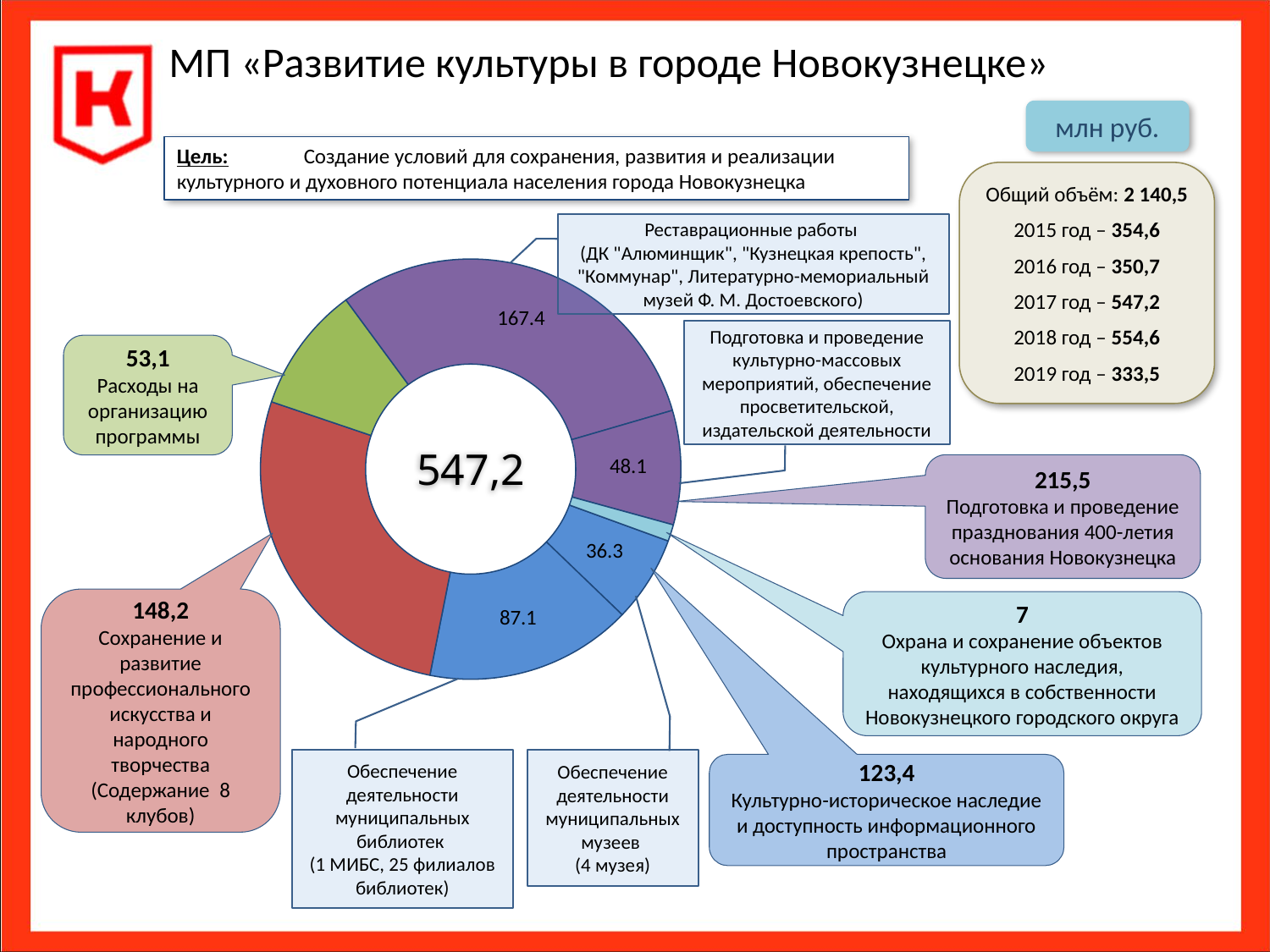
What unit of measurement is indicated for the chart values? млн руб. How many segments does the doughnut chart have? 7 What is the value of the segment for "Обеспечение деятельности муниципальных музеев"? 36.3 What kind of chart is shown on the slide? Doughnut (pie) chart What value is printed in the centre of the doughnut chart? 547,2 What is the value of the segment for "Подготовка и проведение культурно-массовых мероприятий"? 48.1 Which of the labelled segments has the largest value? 167.4 (Реставрационные работы) What is the difference between the libraries segment (87.1) and the museums segment (36.3)? 50.8 What is the difference between the restoration works segment (167.4) and the cultural mass events segment (48.1)? 119.3 Which is larger: the segment for municipal libraries (87.1) or the segment for municipal museums (36.3)? Municipal libraries (87.1) What is the value of the segment for "Реставрационные работы"? 167.4 What is the value of the segment for "Обеспечение деятельности муниципальных библиотек"? 87.1